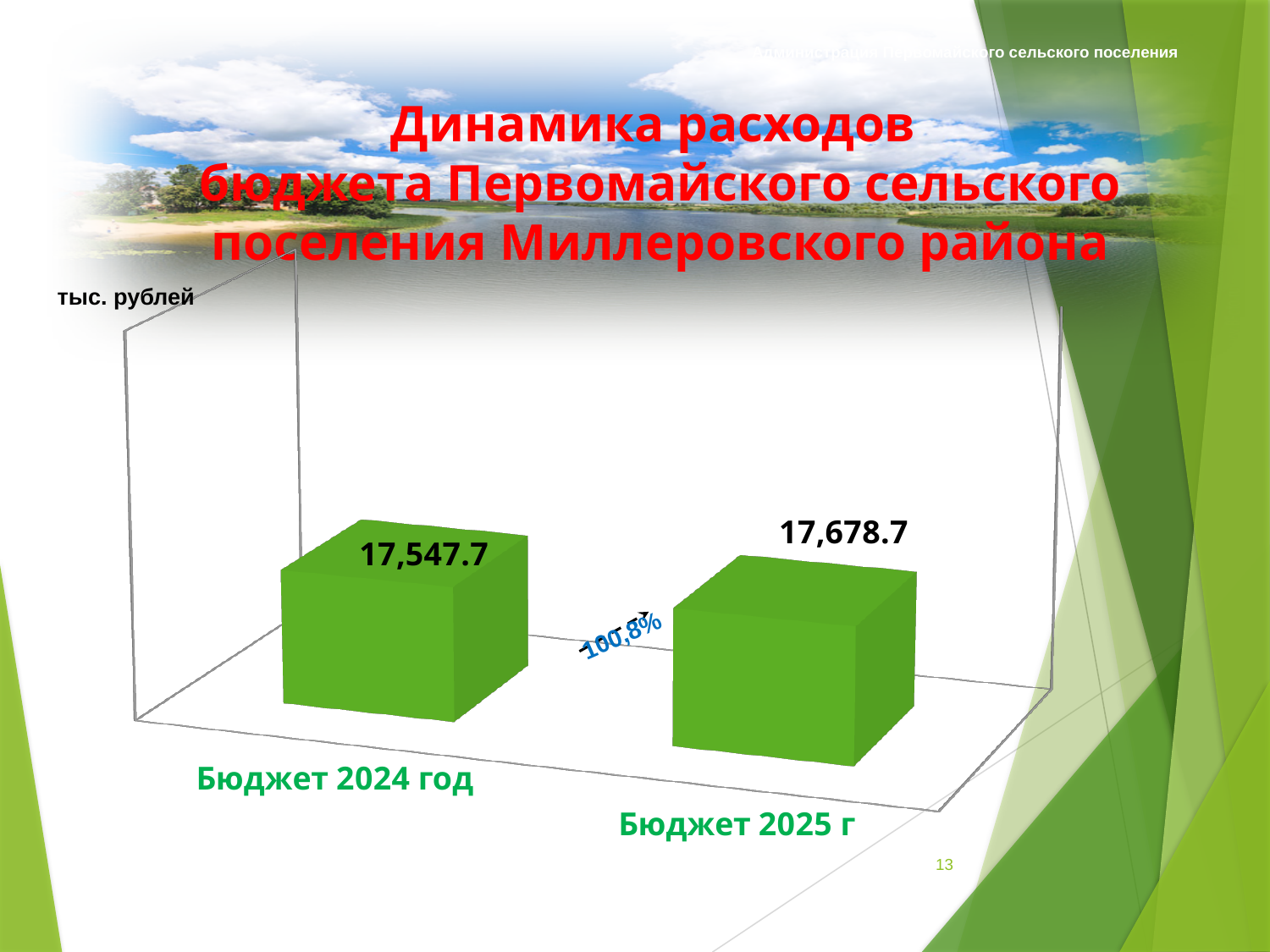
What is the difference between the values for Бюджет 2025 г and Бюджет 2024 год? 131.0 Do the values rise or fall from Бюджет 2024 год to Бюджет 2025 г? Rise What percentage is shown on the arrow between the two bars? 100,8% What is the value for Бюджет 2025 г? 17,678.7 How many categories are shown in the chart? 2 Which is larger, the value for Бюджет 2024 год or the value for Бюджет 2025 г? Бюджет 2025 г What kind of chart is shown on the slide? Bar chart Which category has the highest value? Бюджет 2025 г Which category has the lowest value? Бюджет 2024 год What unit of measurement is indicated for the chart values? тыс. рублей What is the value for Бюджет 2024 год? 17,547.7 What is the title of the chart? Динамика расходов бюджета Первомайского сельского поселения Миллеровского района